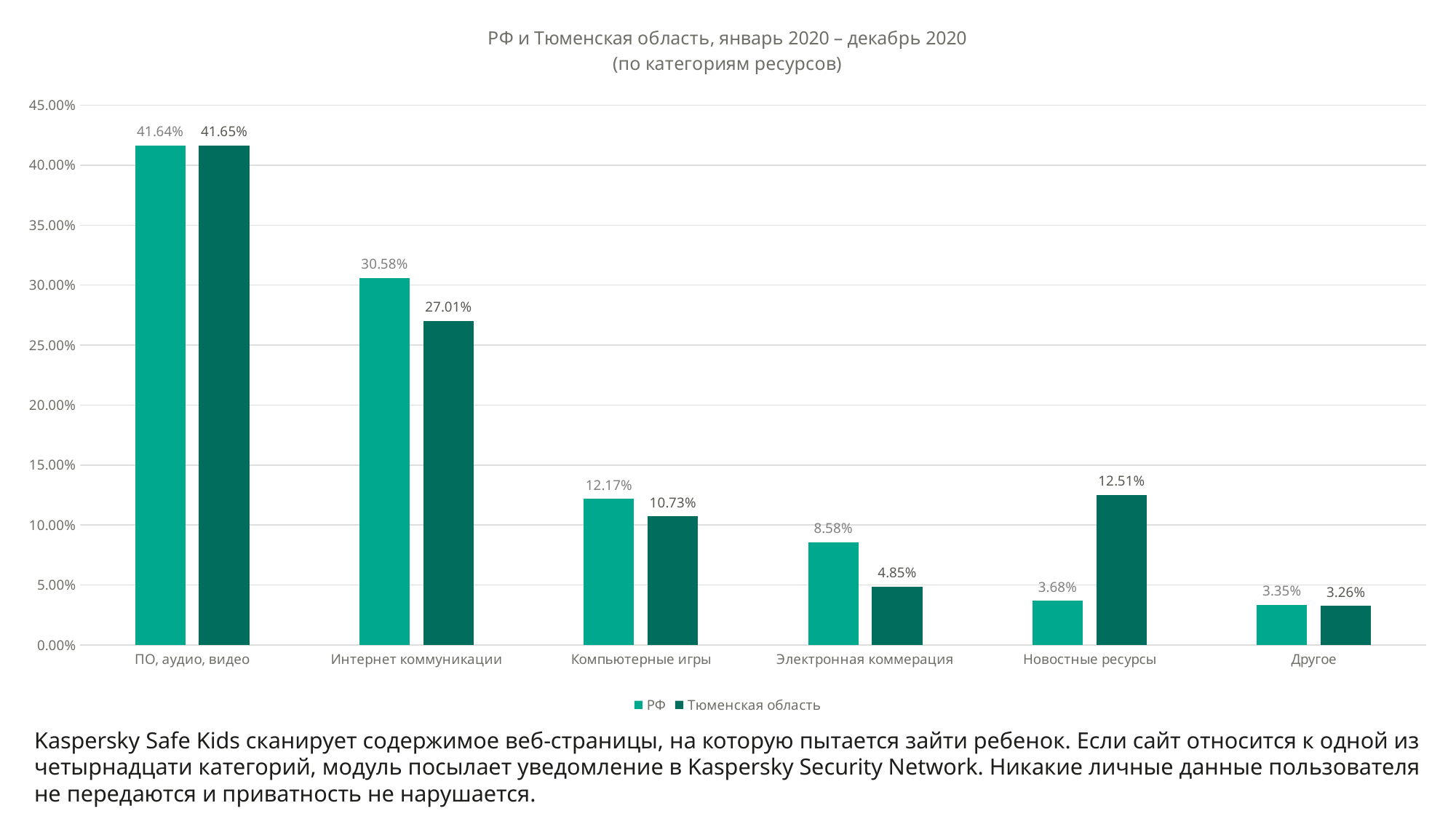
What kind of chart is shown on the slide? bar chart How many series does the legend list? 2 What is the difference between the Тюменская область and РФ values in the Новостные ресурсы category? 8.83% What is the difference between the РФ and Тюменская область values in the Интернет коммуникации category? 3.57% Which category has the lowest value for the Тюменская область series? Другое What is the value for Тюменская область in the Новостные ресурсы category? 12.51% Is the value for РФ in the Электронная коммерация category greater or less than 10.00%? less In the Компьютерные игры category, which series has the larger value, РФ or Тюменская область? РФ What is the value for РФ in the Интернет коммуникации category? 30.58% In the Новостные ресурсы category, which series has the larger value, РФ or Тюменская область? Тюменская область Which category has the highest value for the РФ series? ПО, аудио, видео How many categories are shown on the x axis? 6